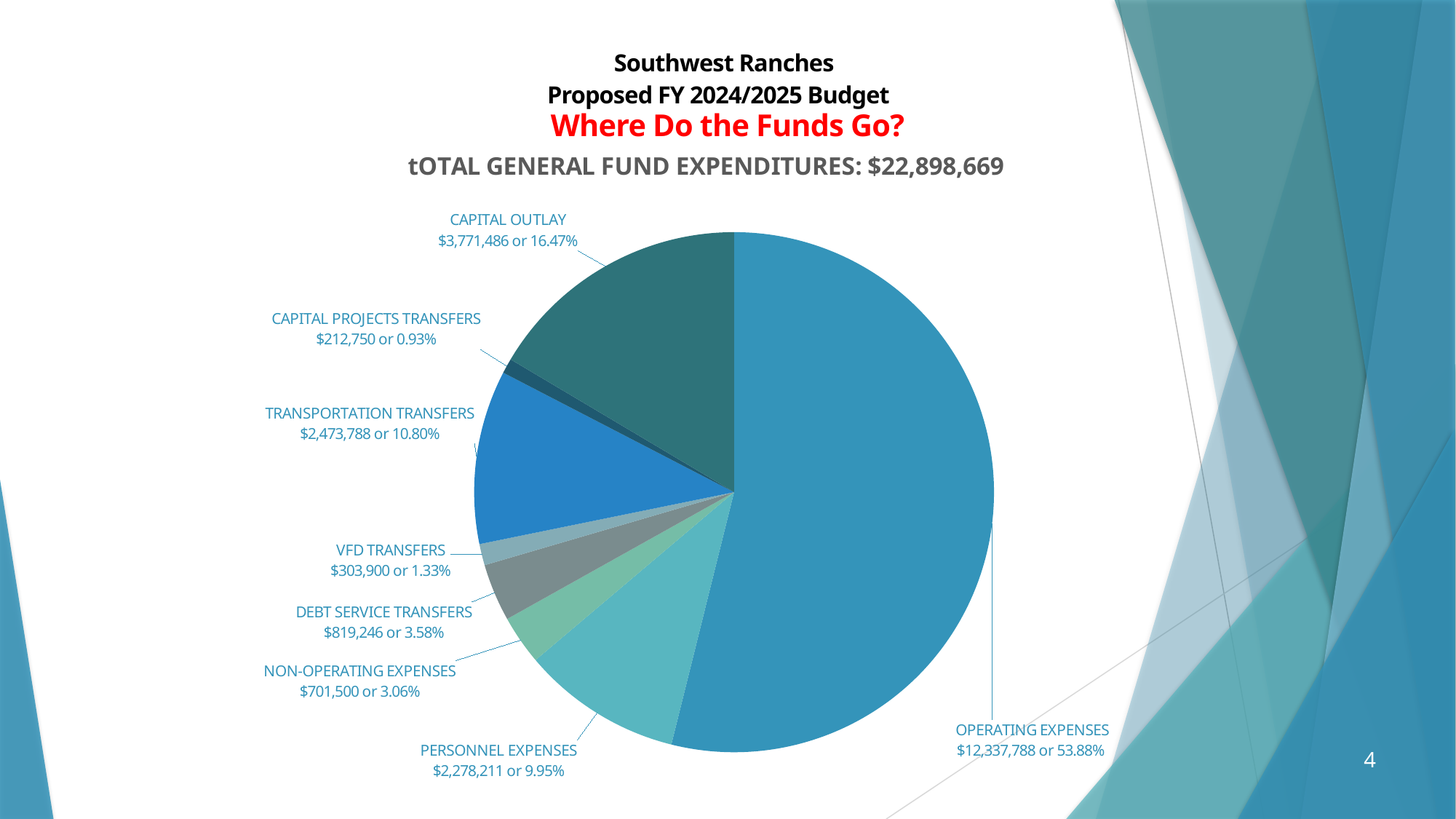
Which category has the smallest slice of the pie? Capital Projects Transfers What is the dollar amount for Operating Expenses? $12,337,788 What share of the pie is Capital Outlay? 16.47% What is the dollar amount for Transportation Transfers? $2,473,788 Which is larger, Debt Service Transfers or Non-Operating Expenses? Debt Service Transfers What total general fund expenditures figure is stated in the chart title? $22,898,669 How many categories are shown in the pie chart? 8 What percentage of the pie is Personnel Expenses? 9.95% Which category has the largest slice of the pie? Operating Expenses What is the difference in dollars between Transportation Transfers and Personnel Expenses? $195,577 What is the difference in dollars between Operating Expenses and Capital Outlay? $8,566,302 What kind of chart is shown on the slide? Pie chart